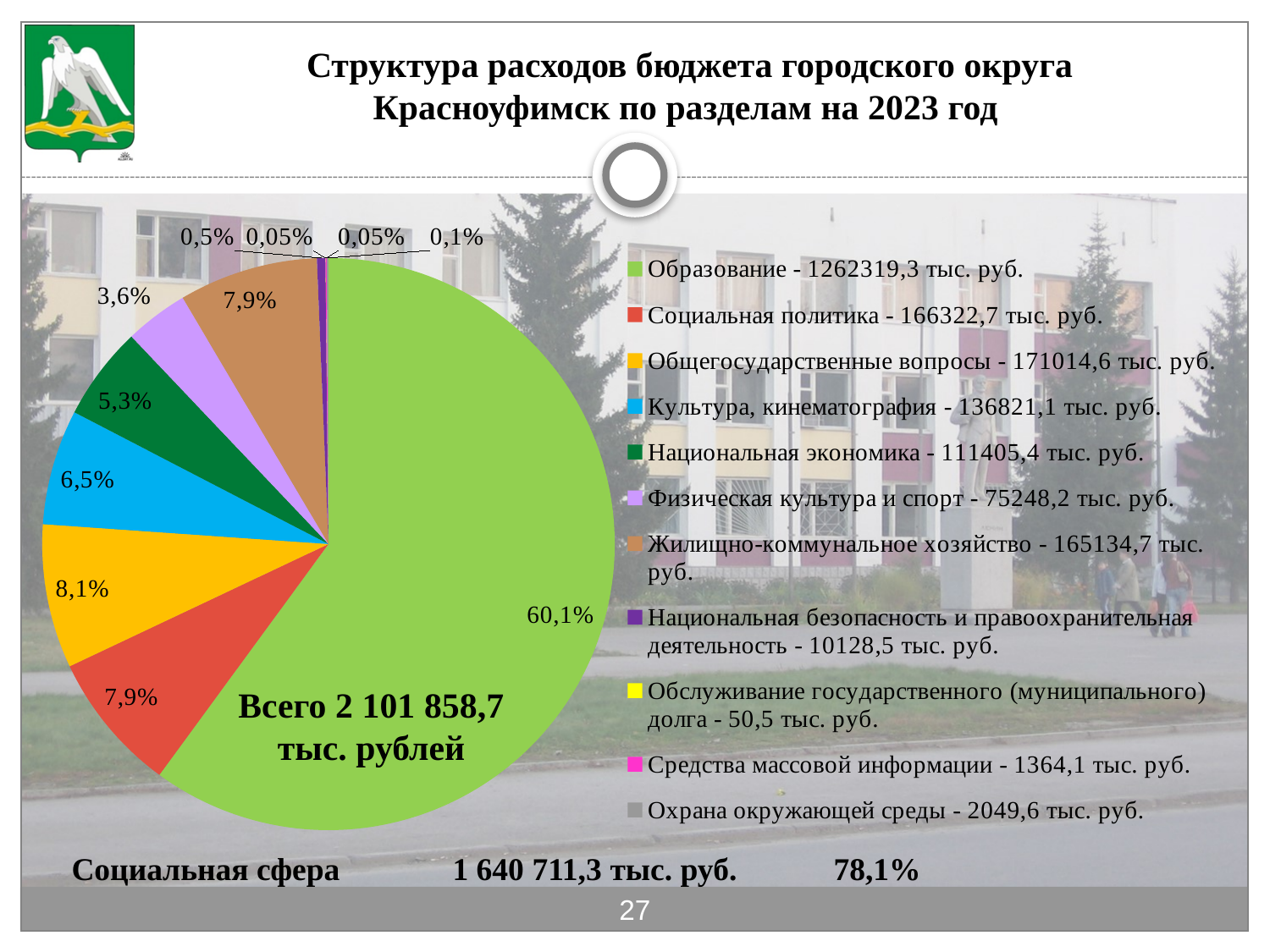
What share of the pie does Общегосударственные вопросы take? 8,1% What kind of chart is shown on the slide? pie chart According to the legend, what is the value for Жилищно-коммунальное хозяйство? 165134,7 тыс. руб. Which category has the smallest value in the legend? Обслуживание государственного (муниципального) долга How many categories does the legend list? 11 What is the difference between the legend values for Общегосударственные вопросы and Социальная политика? 4691,9 тыс. руб. According to the legend, what is the value for Национальная экономика? 111405,4 тыс. руб. What share of the pie does Культура, кинематография take? 6,5% Which category has the largest share of the pie? Образование What share of the pie does Образование take? 60,1% Which is larger: the value for Культура, кинематография or the value for Национальная экономика? Культура, кинематография